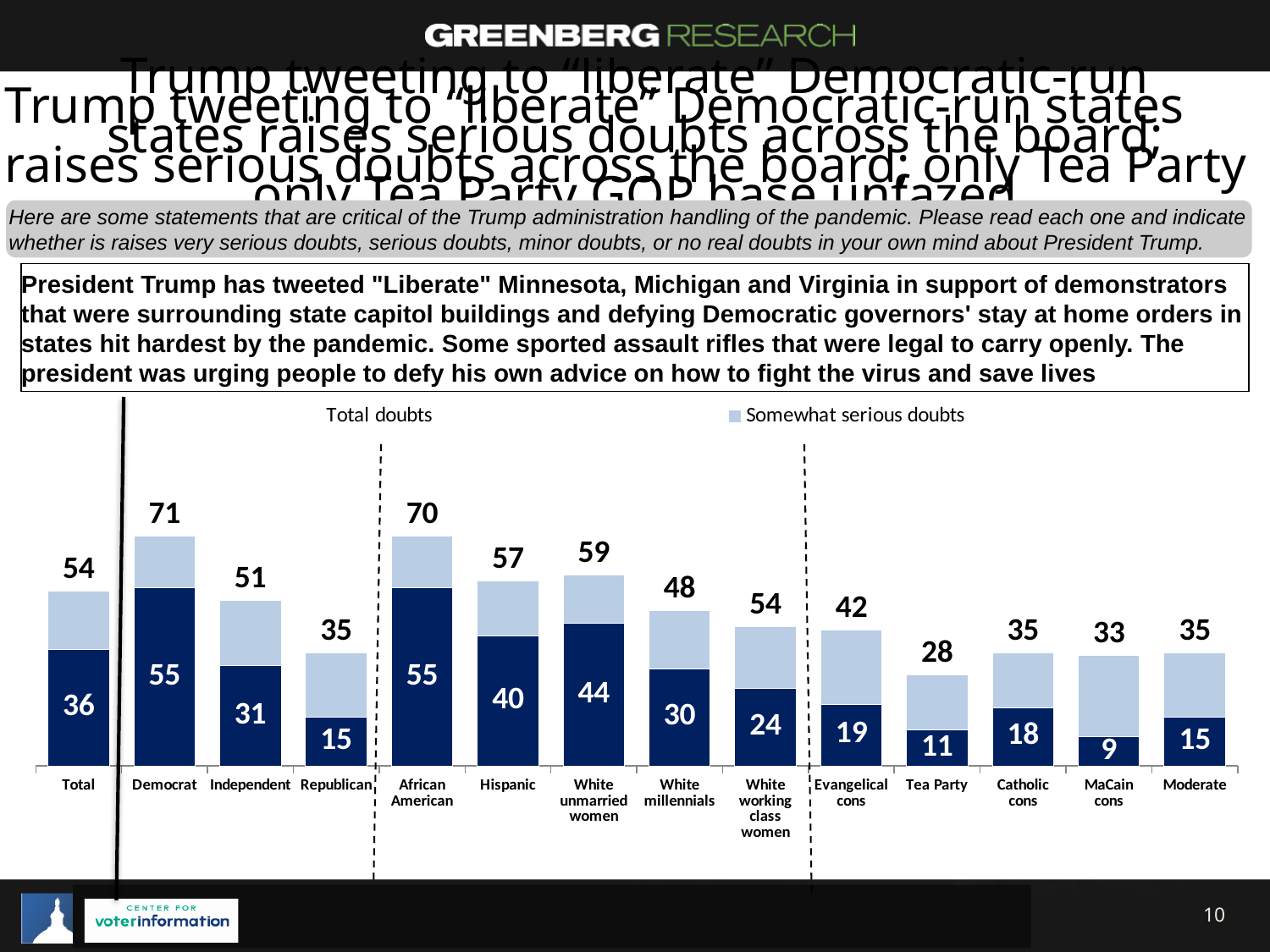
What is the difference between the total doubts values for Democrat and Republican? 36 For the Total category, what is the size of the light blue (somewhat serious doubts) segment, given the total of 54 and the dark blue value of 36? 18 Which has a higher total doubts value, Hispanic or White unmarried women? White unmarried women What value is printed in the dark blue segment of the Tea Party bar? 11 How many categories are shown on the x axis of the chart? 14 What is the total doubts value for Democrat? 71 Which category has the lowest total doubts value? Tea Party Which category has the lowest value in its dark blue segment? MaCain cons What kind of chart is shown on the slide? Stacked bar chart How many entries does the chart legend list? 2 Which category has the highest total doubts value? Democrat What is the total doubts value for White working class women? 54